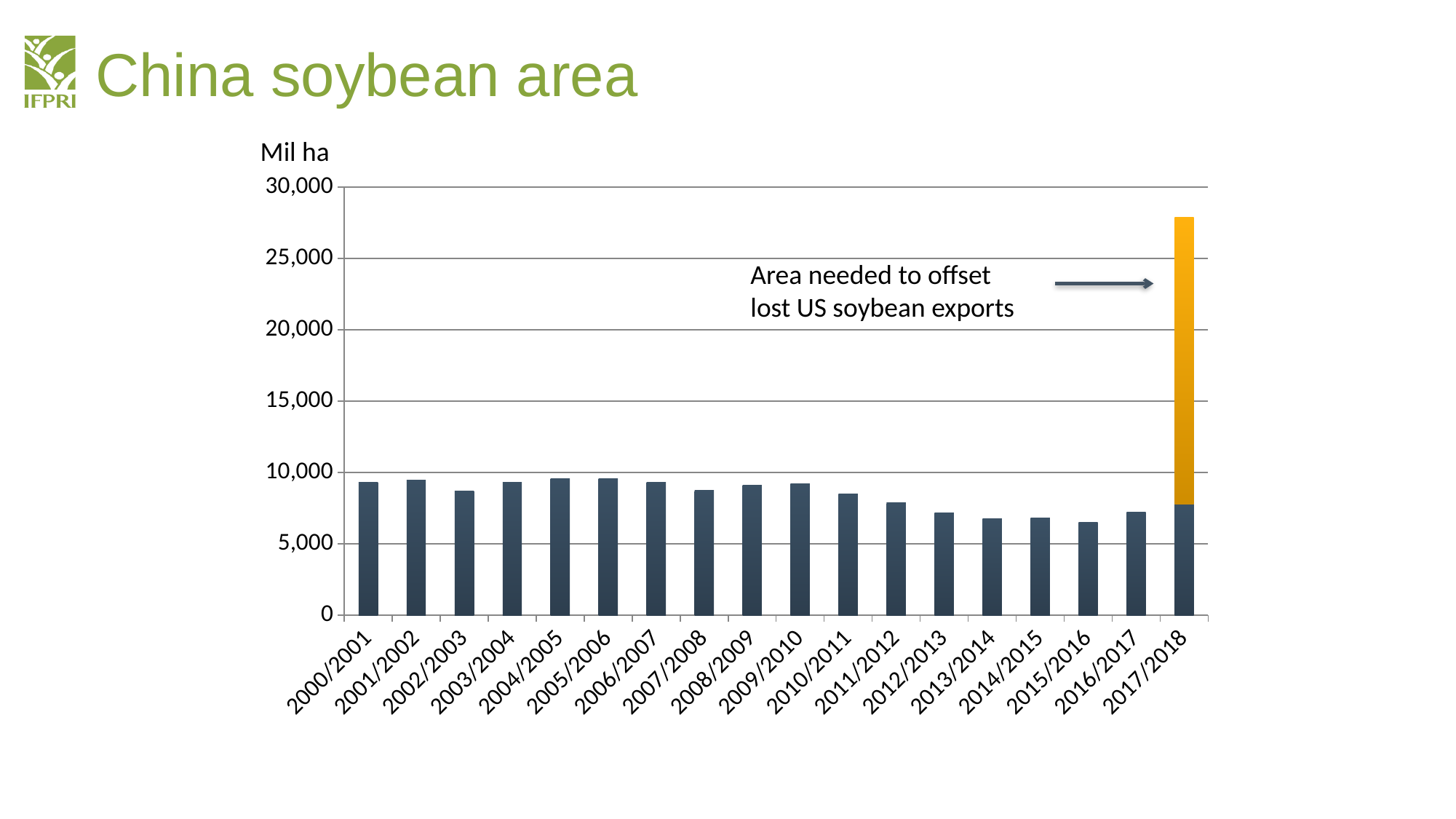
Is the dark blue portion of the 2017/2018 bar greater or less than 10,000? less Is the value for 2000/2001 greater or less than 10,000? less Do the values generally rise or fall from 2009/2010 to 2015/2016? fall What does the annotation say the orange segment of the 2017/2018 bar represents? Area needed to offset lost US soybean exports Which is larger, the value for 2005/2006 or the value for 2015/2016? 2005/2006 Which is larger, the value for 2001/2002 or the value for 2012/2013? 2001/2002 Is the value for 2015/2016 greater or less than 5,000? greater What unit is shown above the y axis of the chart? Mil ha What kind of chart is shown on the slide? bar chart How many marketing years are shown on the x axis of the chart? 18 Which year has the tallest bar in the chart? 2017/2018